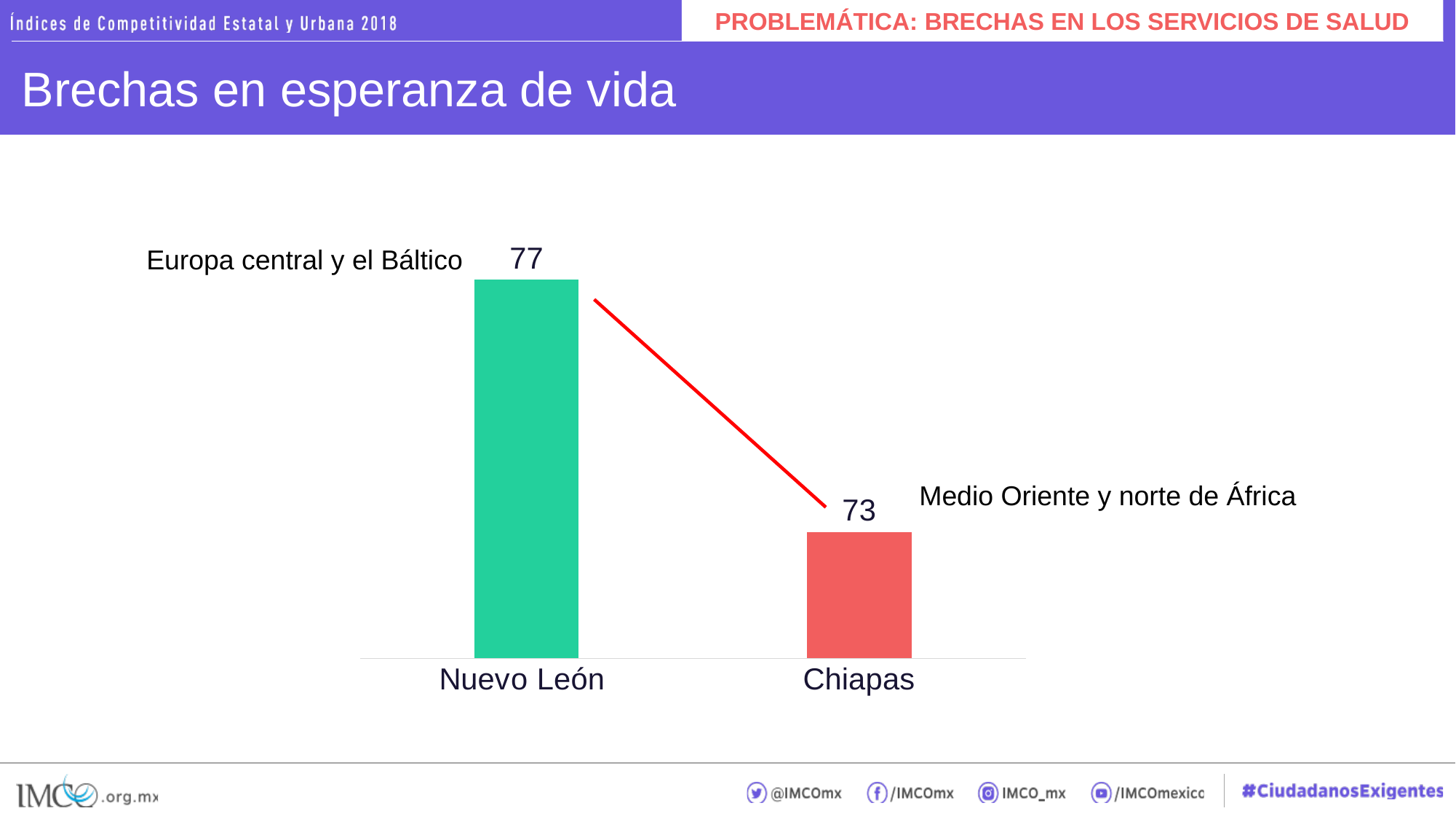
What is the value shown for Chiapas? 73 What is the difference between the values for Nuevo León and Chiapas? 4 Which category has the highest value? Nuevo León What is the title of the slide containing the chart? Brechas en esperanza de vida What kind of chart is shown on the slide? Bar chart How many categories are shown on the x axis? 2 Which is larger, the value for Nuevo León or the value for Chiapas? Nuevo León Do the values rise or fall from Nuevo León to Chiapas? Fall What is the value shown for Nuevo León? 77 Which region label is placed next to the Chiapas bar? Medio Oriente y norte de África Which category has the lowest value? Chiapas